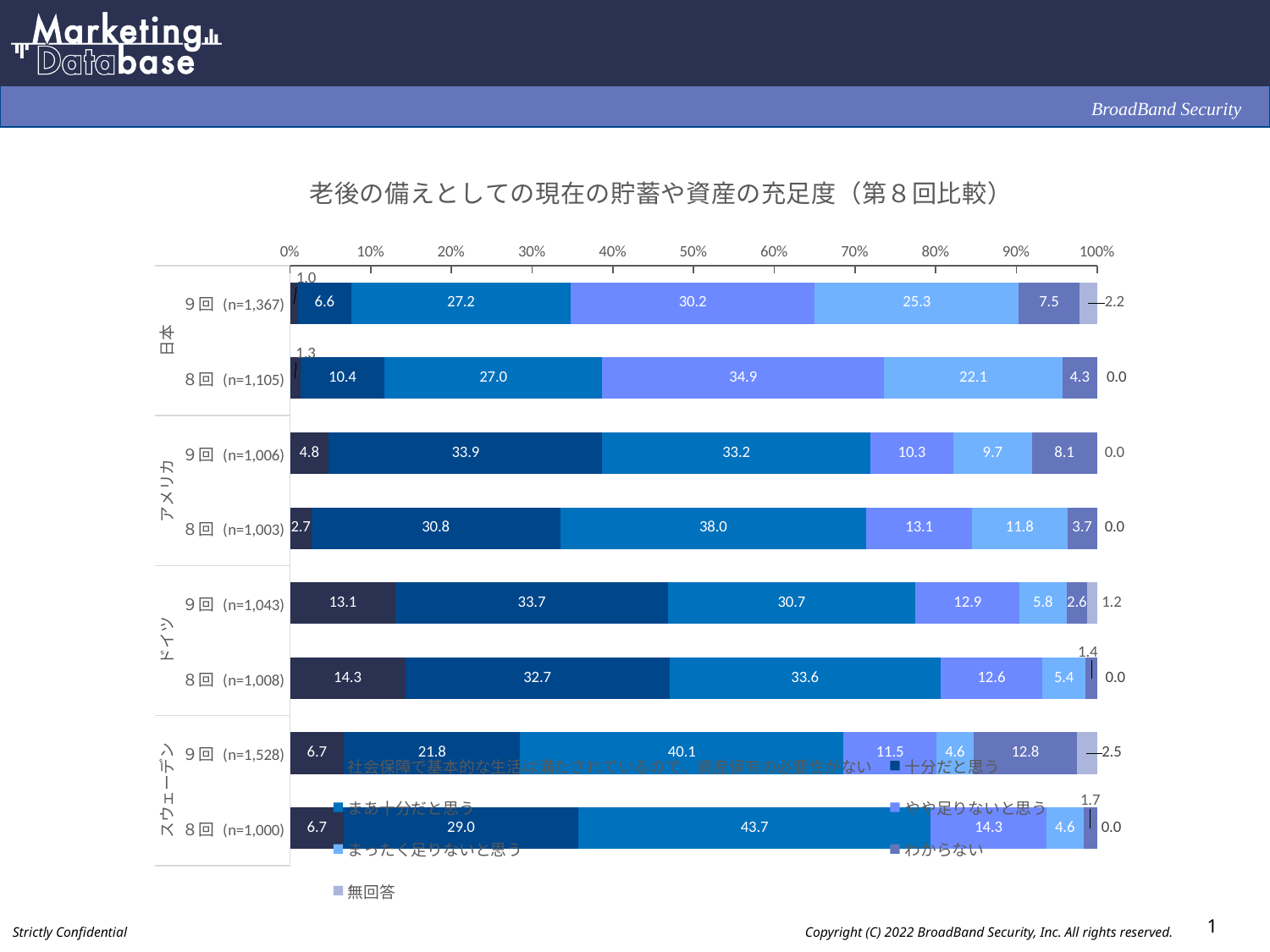
What is the value of the 「まあ十分だと思う」 segment for スウェーデン 8回 (n=1,000)? 43.7 What is the value of the 「まあ十分だと思う」 segment for 日本 9回 (n=1,367)? 27.2 How many bars (survey rounds across countries) are plotted in the chart? 8 What is the title of the chart? 老後の備えとしての現在の貯蓄や資産の充足度（第８回比較） What kind of chart is shown on the slide? Stacked bar chart What is the value of the 「やや足りないと思う」 segment for 日本 8回 (n=1,105)? 34.9 Which bar has the smallest 「社会保障で基本的な生活は満たされているので、資産保有の必要性がない」 segment? 日本 9回 (n=1,367) Which is larger: the 「わからない」 value for スウェーデン 9回 (n=1,528) or for スウェーデン 8回 (n=1,000)? スウェーデン 9回 (n=1,528) Which bar has the largest 「まあ十分だと思う」 segment? スウェーデン 8回 (n=1,000) What is the value of the 「十分だと思う」 segment for アメリカ 9回 (n=1,006)? 33.9 What is the difference between the 「まったく足りないと思う」 values for 日本 9回 (n=1,367) and 日本 8回 (n=1,105)? 3.2 How many series does the legend list? 7